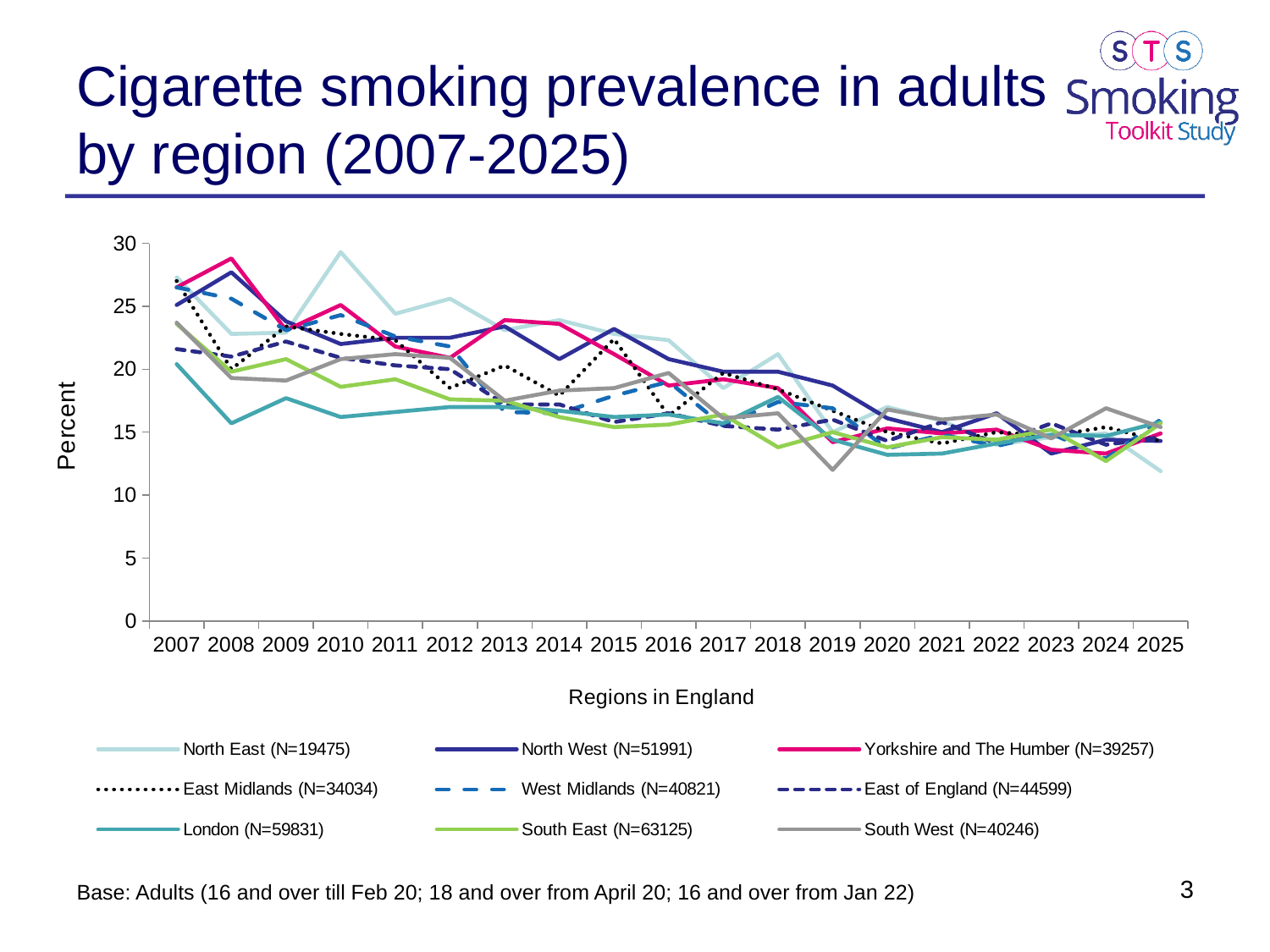
Is the value for Yorkshire and The Humber in 2008 greater or less than 25? greater What kind of chart is shown on the slide? line chart Is the value for London in 2008 greater or less than 20? less In 2010, which is larger: the value for North East or the value for London? North East How many years are shown along the x axis? 19 Does the North East line generally rise or fall from 2007 to 2025? fall What is the label on the y axis? Percent Is the value for South West in 2019 greater or less than 15? less Which region has the lowest value in 2008? London Which region has the highest value in 2010? North East How many series does the legend list? 9